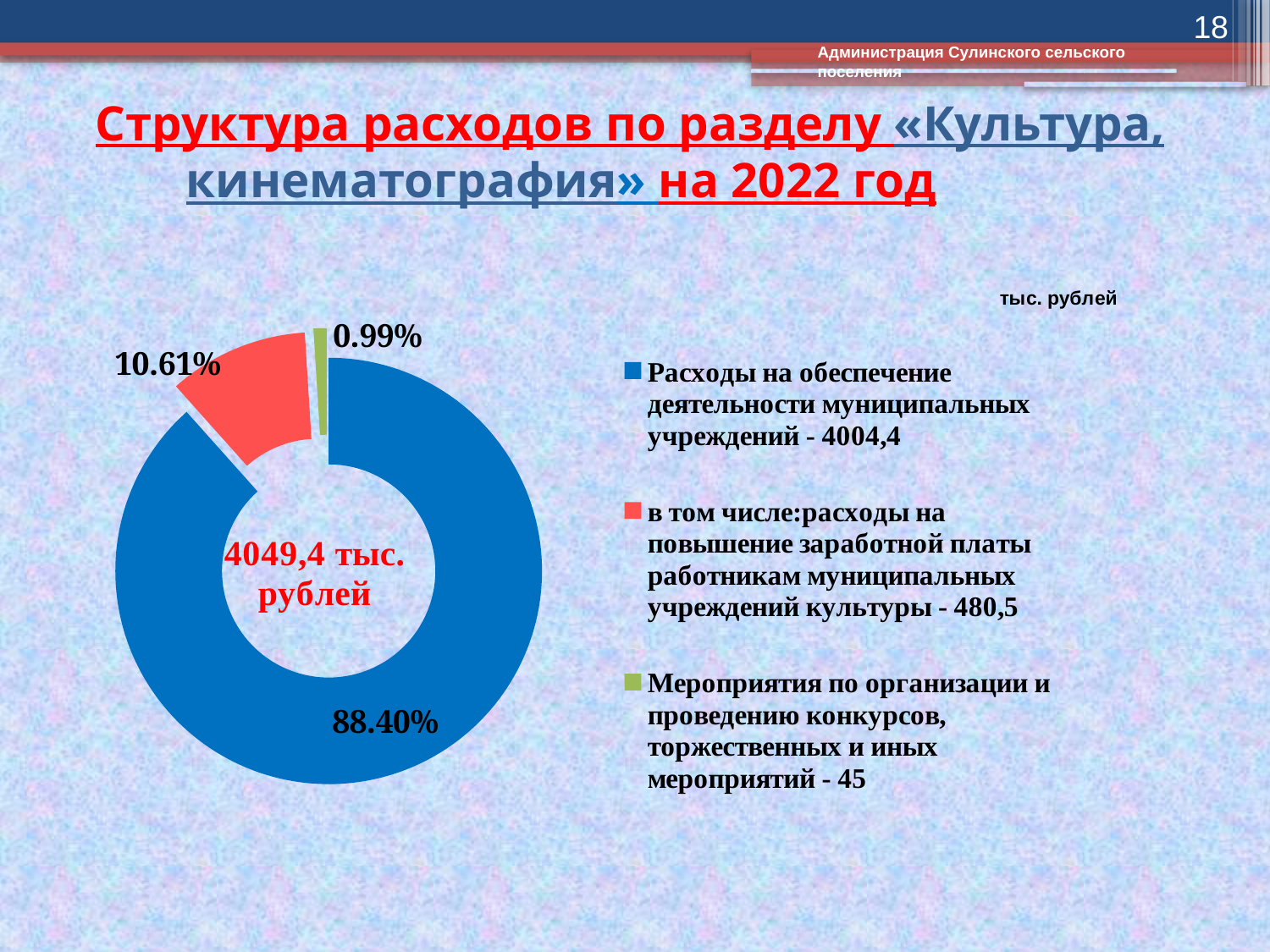
By how many percentage points does the 88.40% slice exceed the 10.61% slice? 77.79 What percentage share is shown for the red slice (расходы на повышение заработной платы работникам муниципальных учреждений культуры)? 10.61% How many slices does the chart have? 3 Which category has the smallest slice of the chart? Мероприятия по организации и проведению конкурсов, торжественных и иных мероприятий What amount (тыс. рублей) is given in the legend for Расходы на обеспечение деятельности муниципальных учреждений? 4004,4 What percentage share is shown for the blue slice (Расходы на обеспечение деятельности муниципальных учреждений)? 88.40% What percentage share is shown for the green slice (Мероприятия по организации и проведению конкурсов, торжественных и иных мероприятий)? 0.99% How many entries does the legend list? 3 What total is printed in the centre of the doughnut chart? 4049,4 тыс. рублей Which category has the largest slice of the chart? Расходы на обеспечение деятельности муниципальных учреждений What kind of chart is shown on the slide? pie chart (doughnut) What amount (тыс. рублей) is given in the legend for Мероприятия по организации и проведению конкурсов, торжественных и иных мероприятий? 45